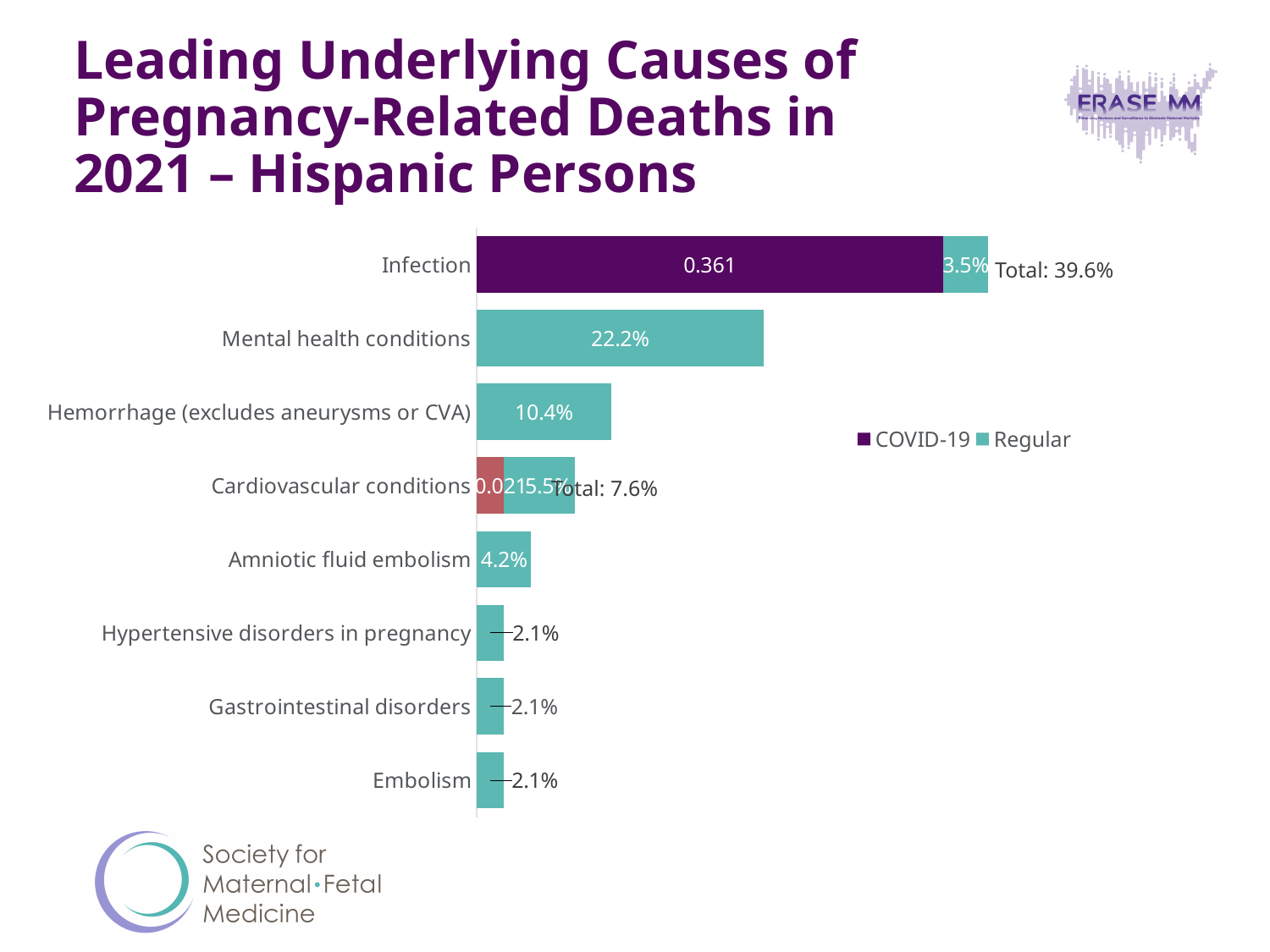
What is the value for Hemorrhage (excludes aneurysms or CVA)? 10.4% What is the value for Mental health conditions? 22.2% What is the Regular value for Infection? 3.5% How many series does the legend list? 2 What is the difference between the values for Mental health conditions and Hemorrhage (excludes aneurysms or CVA)? 11.8% Which cause has the highest total value? Infection What are the two series named in the legend? COVID-19 and Regular How many causes of death are listed on the chart? 8 What is the value for Amniotic fluid embolism? 4.2% What is the total shown for Infection? Total: 39.6% What kind of chart is shown on the slide? bar chart Which is larger, the value for Mental health conditions or for Hemorrhage (excludes aneurysms or CVA)? Mental health conditions